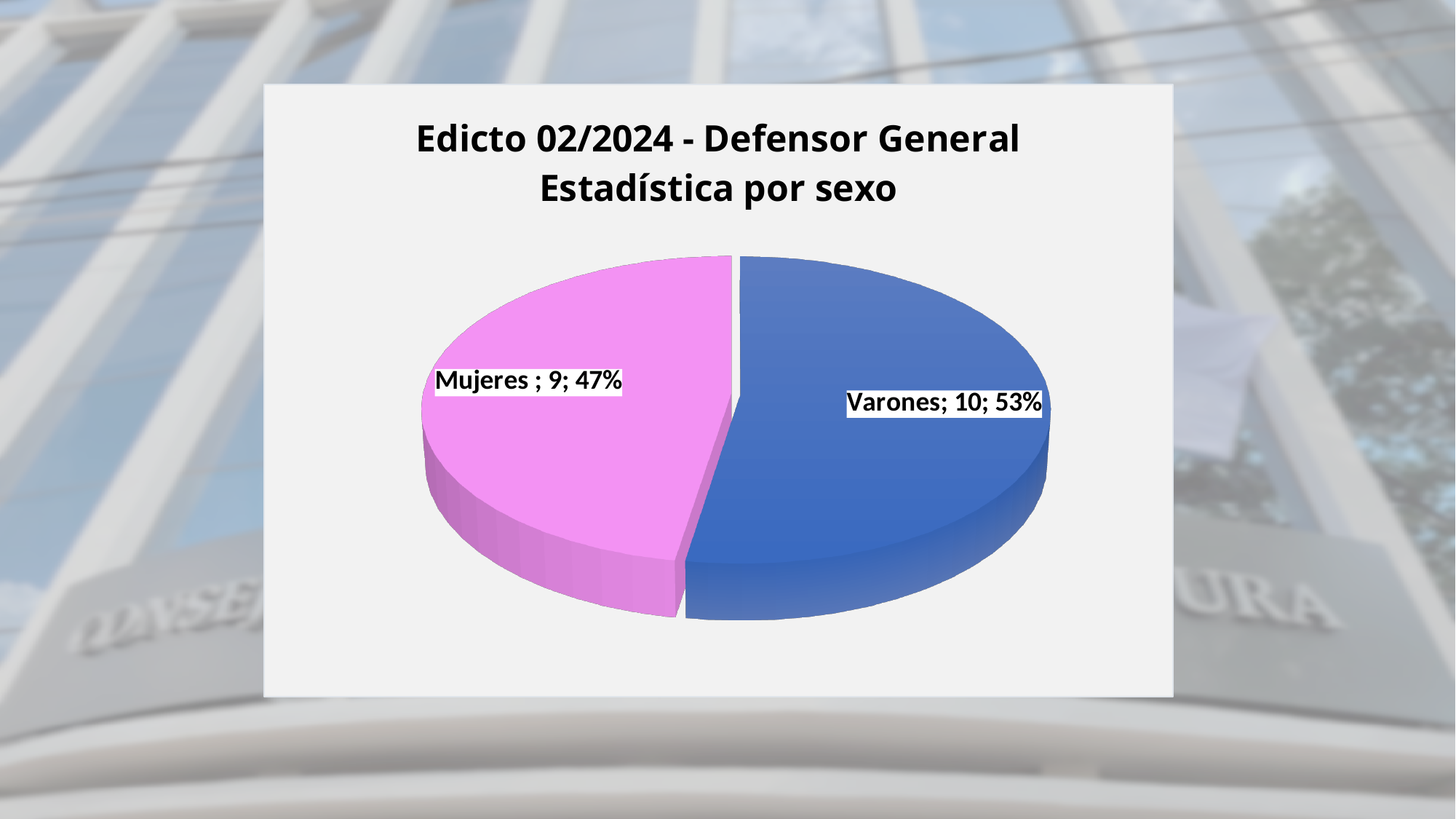
What share of the pie does Varones represent? 53% Which category has the smallest slice? Mujeres Which is larger, the count for Mujeres or the count for Varones? Varones What share of the pie does Mujeres represent? 47% Which category has the largest slice? Varones What kind of chart is shown on the slide? pie chart What is the count for Varones? 10 What colour is the Mujeres slice? pink What is the count for Mujeres? 9 How many slices does the pie chart have? 2 What is the difference between the counts for Varones and Mujeres? 1 What is the title of the chart? Edicto 02/2024 - Defensor General Estadística por sexo